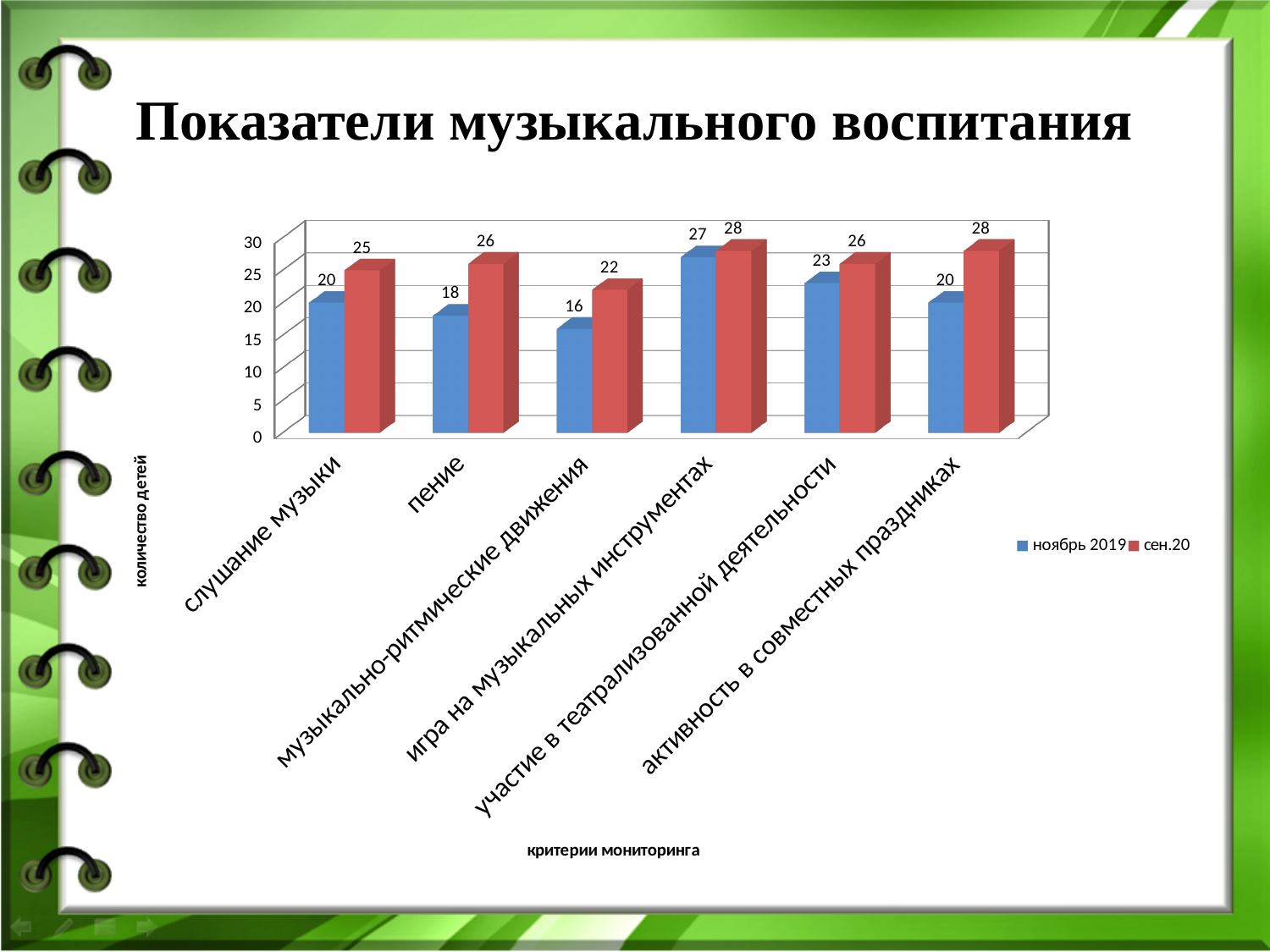
Which category has the highest value in the "ноябрь 2019" series? игра на музыкальных инструментах What is the value for "музыкально-ритмические движения" in the "сен.20" series? 22 Which is larger for "слушание музыки": the "ноябрь 2019" value or the "сен.20" value? сен.20 What is the difference between the "сен.20" and "ноябрь 2019" values for "активность в совместных праздниках"? 8 What kind of chart is shown on the slide? bar chart How many series does the legend list? 2 Which category has the lowest value in the "ноябрь 2019" series? музыкально-ритмические движения What is the value for "пение" in the "ноябрь 2019" series? 18 What is the difference between the "сен.20" and "ноябрь 2019" values for "пение"? 8 What is the label of the vertical axis? количество детей How many categories are shown on the x axis? 6 What is the value for "активность в совместных праздниках" in the "ноябрь 2019" series? 20